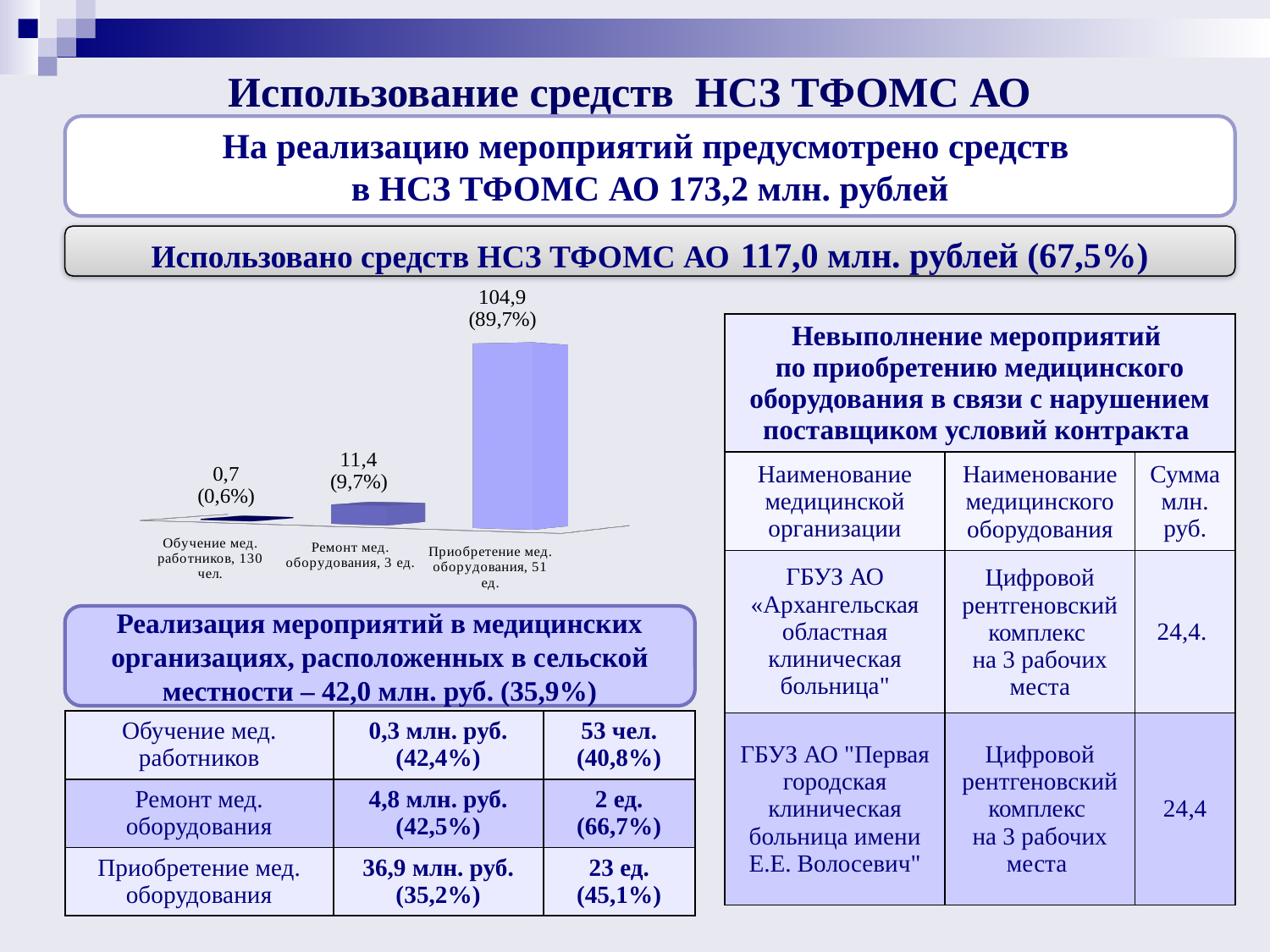
How many bars are plotted in the chart? 3 What is the difference between the values for "Приобретение мед. оборудования" and "Ремонт мед. оборудования"? 93,5 Which category has the highest bar in the chart? Приобретение мед. оборудования Which category has the lowest bar in the chart? Обучение мед. работников What percentage is printed in parentheses above the bar for "Ремонт мед. оборудования"? 9,7% What value is shown for the bar labelled "Ремонт мед. оборудования, 3 ед."? 11,4 What value is shown for the bar labelled "Обучение мед. работников, 130 чел."? 0,7 What type of chart is shown on the slide? Bar chart What percentage is printed in parentheses above the bar for "Обучение мед. работников"? 0,6% What percentage is printed in parentheses above the bar for "Приобретение мед. оборудования"? 89,7% What value is shown for the bar labelled "Приобретение мед. оборудования, 51 ед."? 104,9 Which is larger: the value for "Ремонт мед. оборудования" or the value for "Обучение мед. работников"? Ремонт мед. оборудования